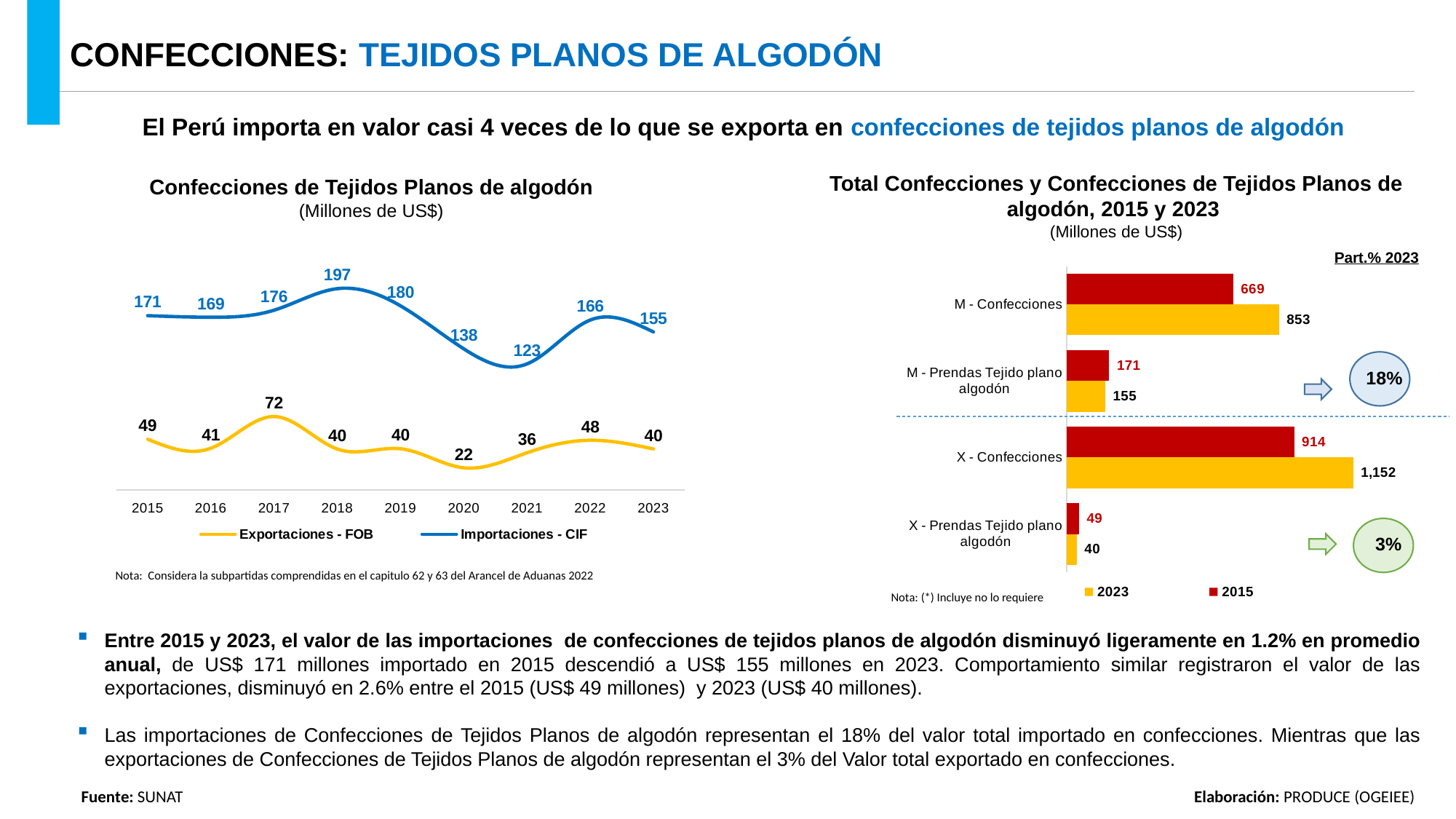
In the 'Confecciones de Tejidos Planos de algodón' line chart, how many years are shown on the x axis? 9 In the 'Confecciones de Tejidos Planos de algodón' line chart, what is the value of Exportaciones - FOB in 2020? 22 In the 'Total Confecciones y Confecciones de Tejidos Planos de algodón, 2015 y 2023' chart, what is the 2023 value for X - Confecciones? 1,152 In the 'Confecciones de Tejidos Planos de algodón' line chart, how many series does the legend list? 2 In the 'Total Confecciones y Confecciones de Tejidos Planos de algodón, 2015 y 2023' chart, which is larger for M - Prendas Tejido plano algodón: the 2015 value or the 2023 value? 2015 What type of chart is the 'Confecciones de Tejidos Planos de algodón' chart on the left? Line chart In the 'Total Confecciones y Confecciones de Tejidos Planos de algodón, 2015 y 2023' chart, what is the 2015 value for M - Confecciones? 669 In the 'Confecciones de Tejidos Planos de algodón' line chart, what is the value of Importaciones - CIF in 2018? 197 What type of chart is the 'Total Confecciones y Confecciones de Tejidos Planos de algodón, 2015 y 2023' chart on the right? Bar chart In the 'Confecciones de Tejidos Planos de algodón' line chart, which year has the lowest Importaciones - CIF value? 2021 In the 'Confecciones de Tejidos Planos de algodón' line chart, which year has the highest Exportaciones - FOB value? 2017 In the 'Confecciones de Tejidos Planos de algodón' line chart, what is the difference between Importaciones - CIF and Exportaciones - FOB in 2023? 115